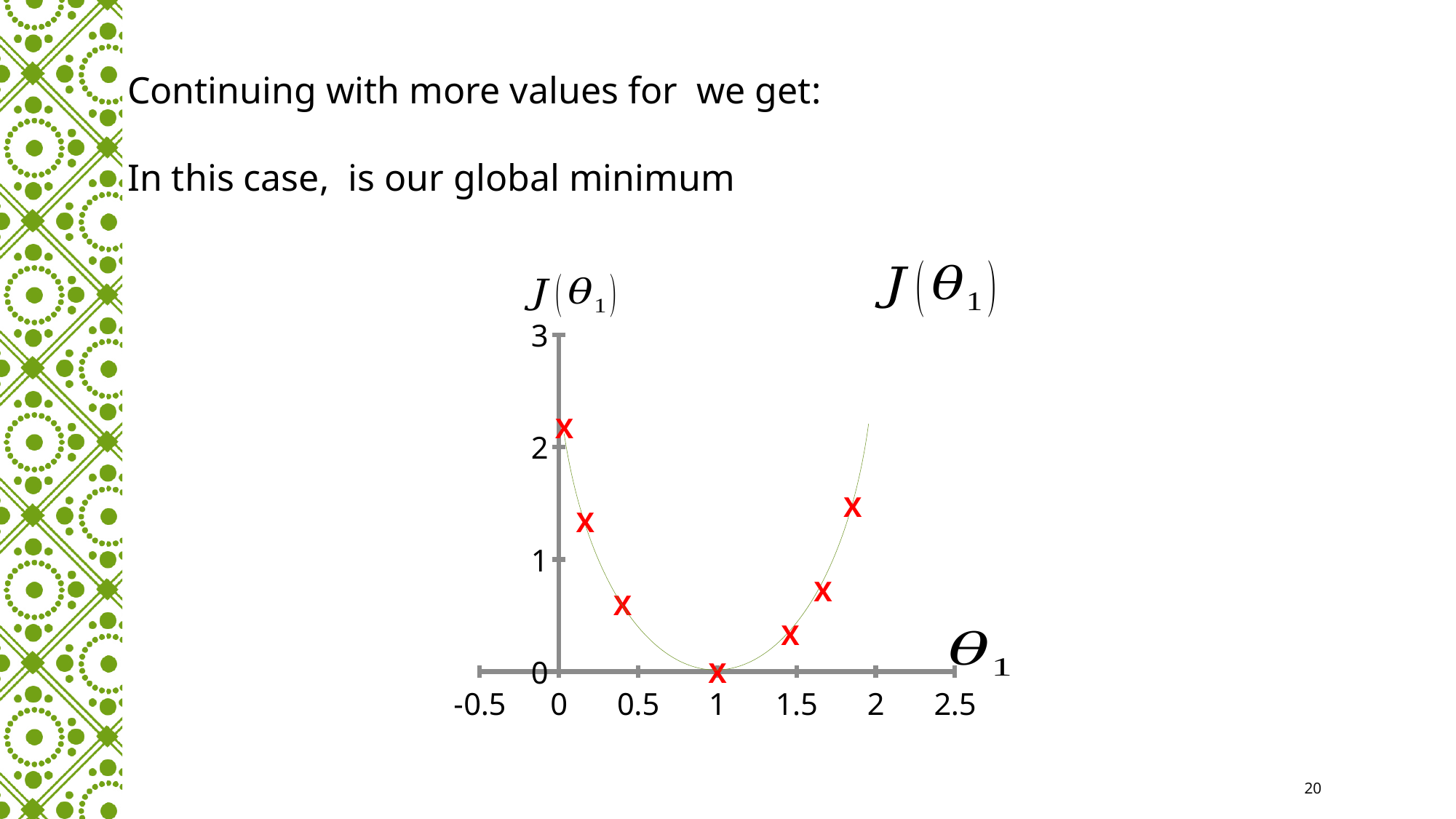
Do the plotted values rise or fall as θ1 increases from 0 to 1? fall At which value of θ1 does the plotted curve reach its minimum? 1 Which plotted point has the highest J(θ1) value: the one at θ1 = 0 or the rightmost one? the one at θ1 = 0 Is the value of J(θ1) for the leftmost plotted point (at θ1 = 0) greater or less than 2? greater What kind of chart is shown on the slide? scatter chart Is the value of J(θ1) for the rightmost plotted point greater or less than 1? greater What is the value of J(θ1) at the lowest plotted point? 0 Do the plotted values rise or fall as θ1 increases from 1 to 2? rise How many red X data points are plotted on the chart? 7 What label is shown on the horizontal axis of the chart? θ1 Is the value of J(θ1) for the plotted point just right of θ1 = 1.5 greater or less than 1? less What is the highest value labelled on the vertical axis? 3